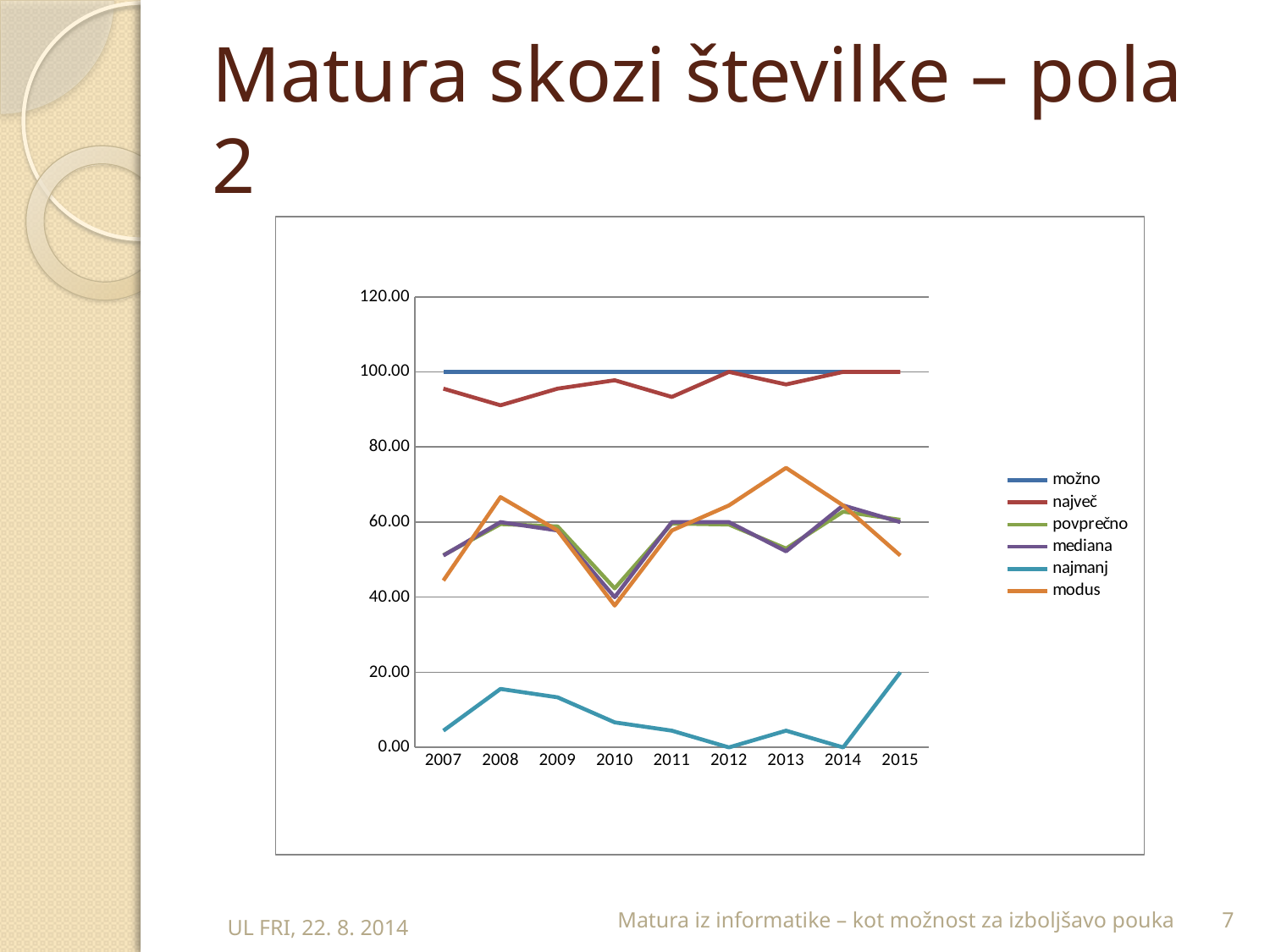
In which year does the 'najmanj' series reach its highest value? 2015 Which is larger in 2008: the value of 'možno' or the value of 'največ'? možno Is the value of 'največ' in 2008 greater or less than 80.00? greater Is the value of 'najmanj' in 2008 greater or less than 20.00? less What kind of chart is shown on the slide? line chart Is the value of 'modus' in 2013 greater or less than 60.00? greater How many series does the chart legend list? 6 In which year does the 'modus' series reach its highest value? 2013 What is the value of the 'možno' series in 2010? 100.00 Does the 'najmanj' series rise or fall from 2008 to 2012? fall Which series is drawn in orange in the chart? modus How many years are plotted along the x axis of the chart? 9